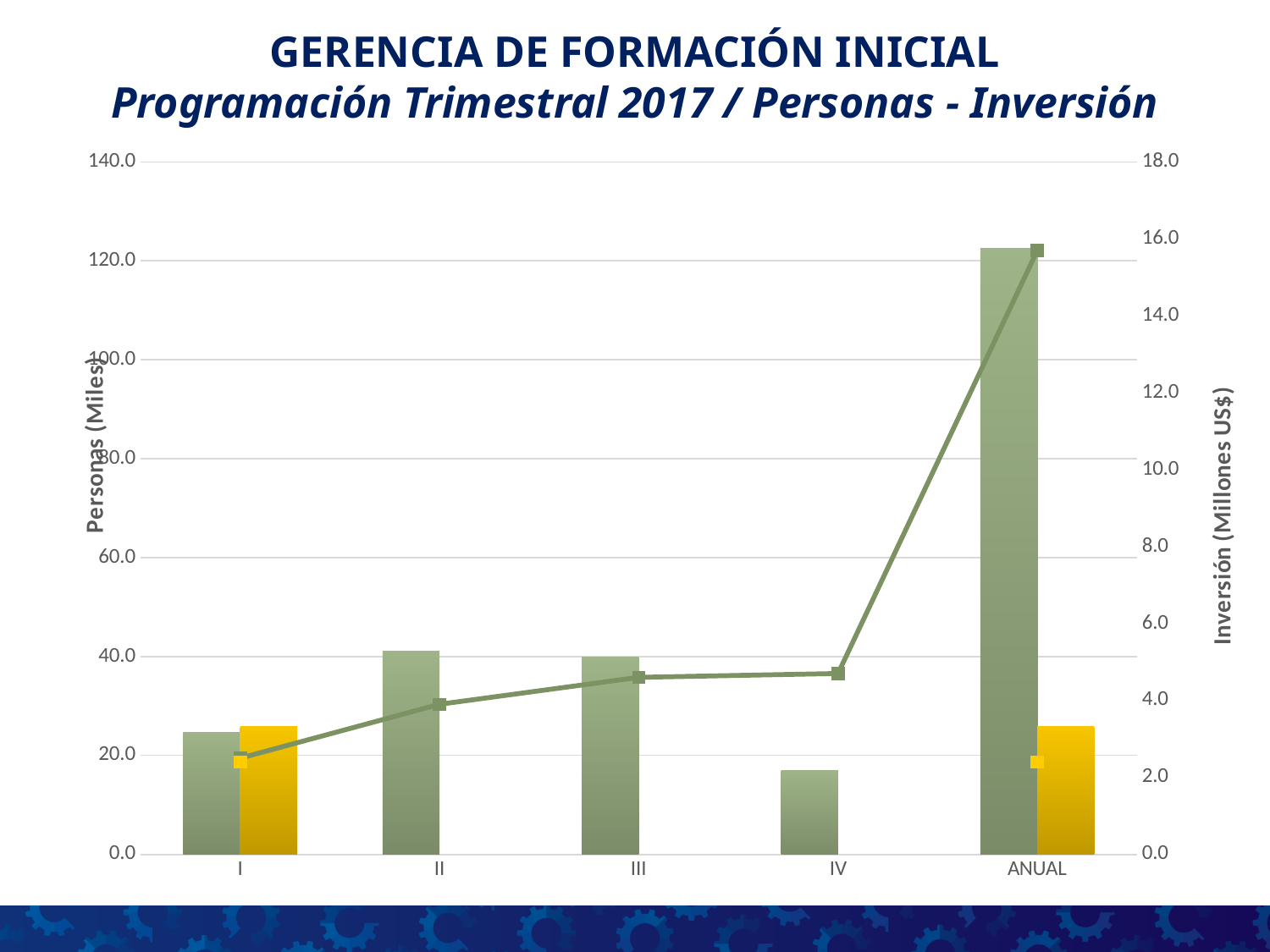
Is the green bar for IV greater or less than 20.0 on the left axis? less Is the green bar for I greater or less than 20.0 on the left axis? greater Which category has the tallest green bar? ANUAL What kind of chart is shown on the slide? A combination bar and line chart Is the green line value for I greater or less than 4.0 on the right axis? less Does the green line rise or fall from I to ANUAL? It rises Which category has the shortest green bar? IV How many categories are shown on the x axis? 5 What is the title of the right-hand vertical axis? Inversión (Millones US$) Which green bar is taller, II or IV? II